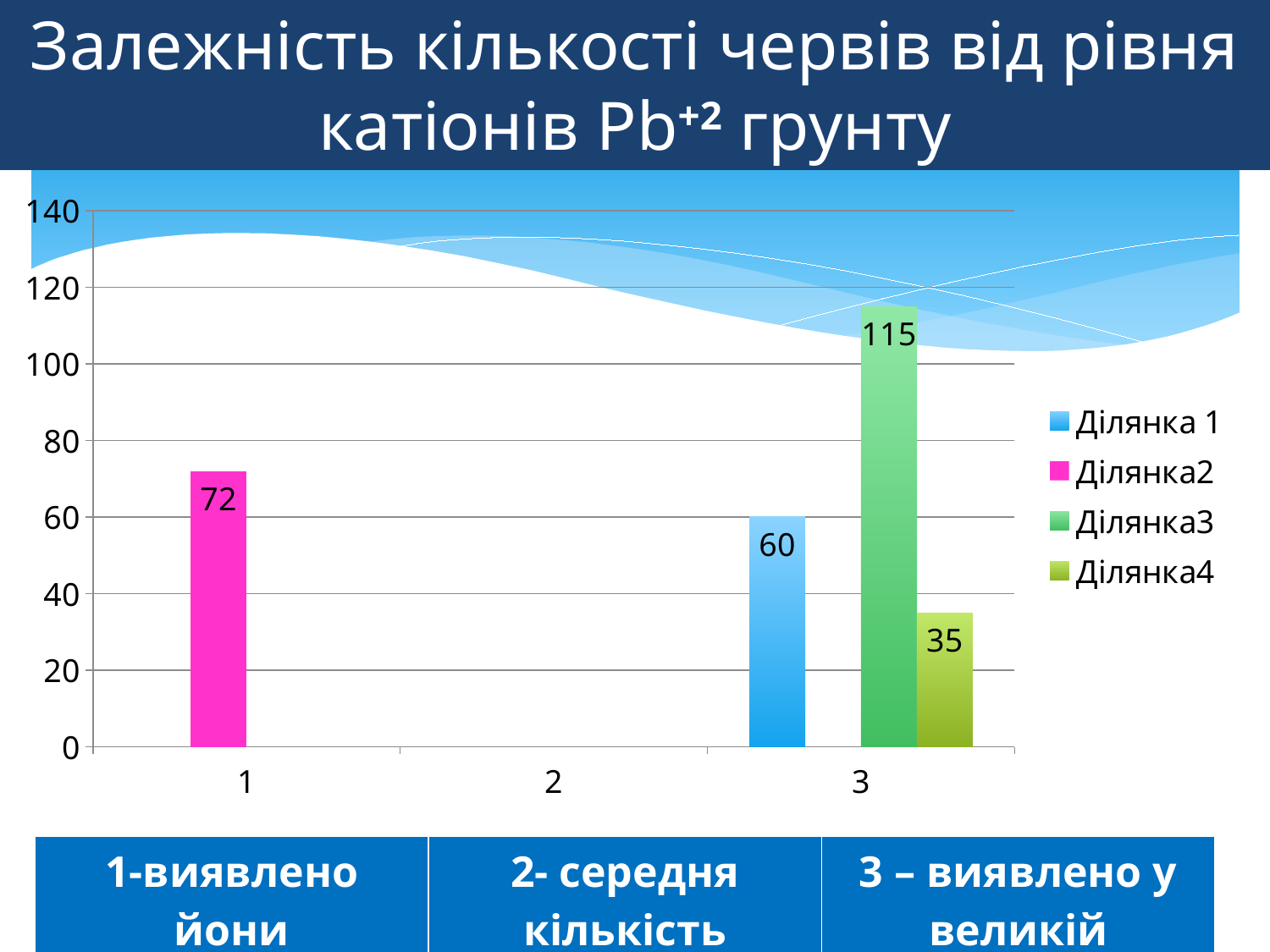
What is the value of the Ділянка2 bar at category 1? 72 What colour is the Ділянка2 series in the legend? pink Which is larger: the Ділянка2 bar at category 1 or the Ділянка 1 bar at category 3? Ділянка2 bar at category 1 What is the value of the Ділянка4 bar at category 3? 35 Which series has the highest bar on the chart? Ділянка3 How many categories are shown on the x axis? 3 What is the value of the Ділянка 1 bar at category 3? 60 Which series has the lowest bar on the chart? Ділянка4 How many series does the legend list? 4 What is the difference between the Ділянка3 bar and the Ділянка4 bar at category 3? 80 What is the value of the Ділянка3 bar at category 3? 115 What kind of chart is shown on the slide? bar chart